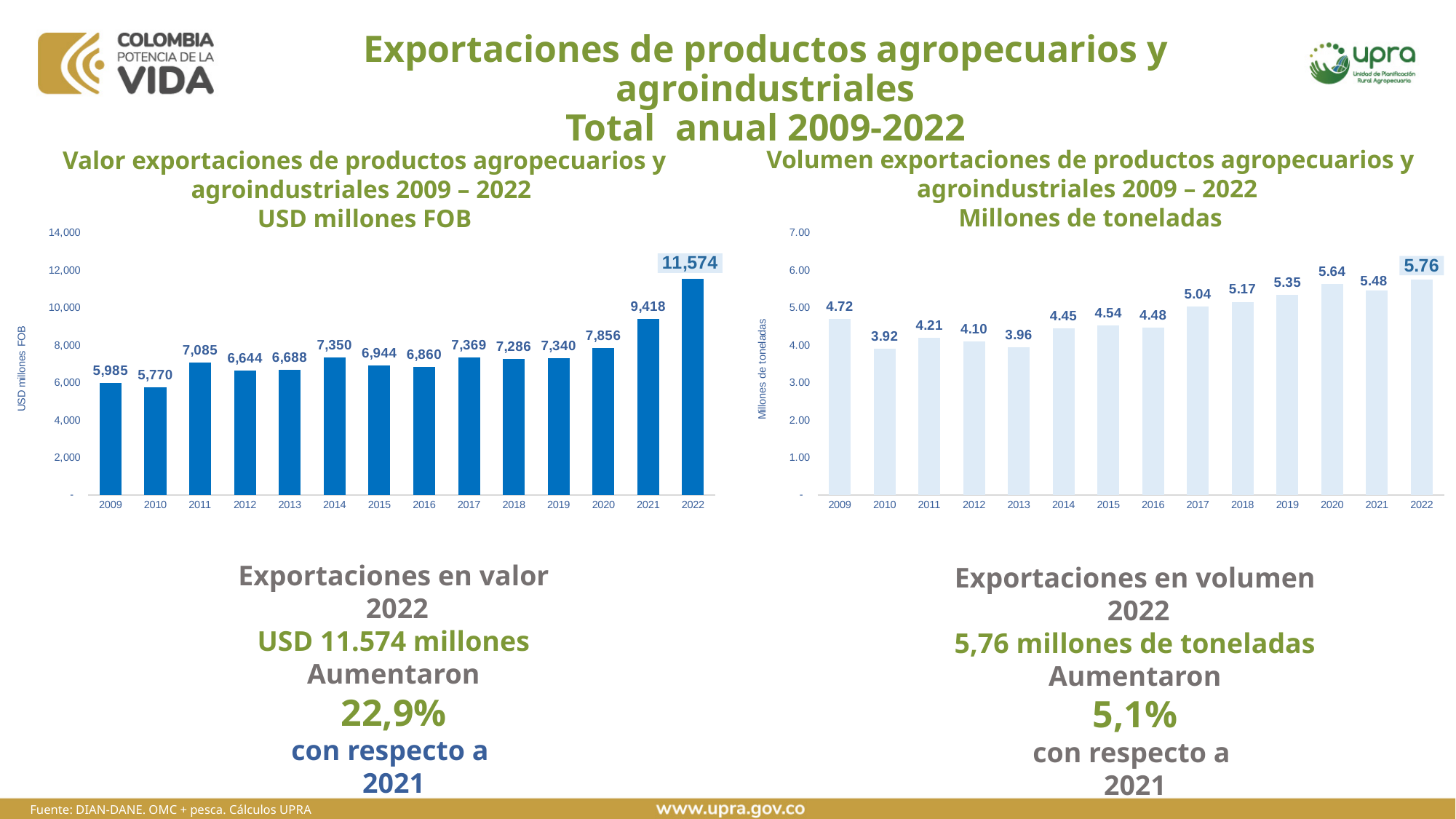
In the right chart (Volumen exportaciones), what is the y-axis label? Millones de toneladas In the right chart (Volumen exportaciones), which is larger, the value for 2020 or the value for 2021? 2020 In the right chart (Volumen exportaciones), what is the value for 2017? 5.04 In the right chart (Volumen exportaciones), which year has the lowest value? 2010 In the left chart (Valor exportaciones), what kind of chart is shown? Bar chart In the left chart (Valor exportaciones), what is the difference between the 2022 value and the 2021 value? 2,156 In the left chart (Valor exportaciones), which year has the lowest value? 2010 In the right chart (Volumen exportaciones), which year has the highest value? 2022 In the left chart (Valor exportaciones), how many years are plotted? 14 In the left chart (Valor exportaciones), which year has the highest value? 2022 In the right chart (Volumen exportaciones), what is the difference between the 2022 value and the 2021 value? 0.28 In the left chart (Valor exportaciones), what is the value for 2021? 9,418